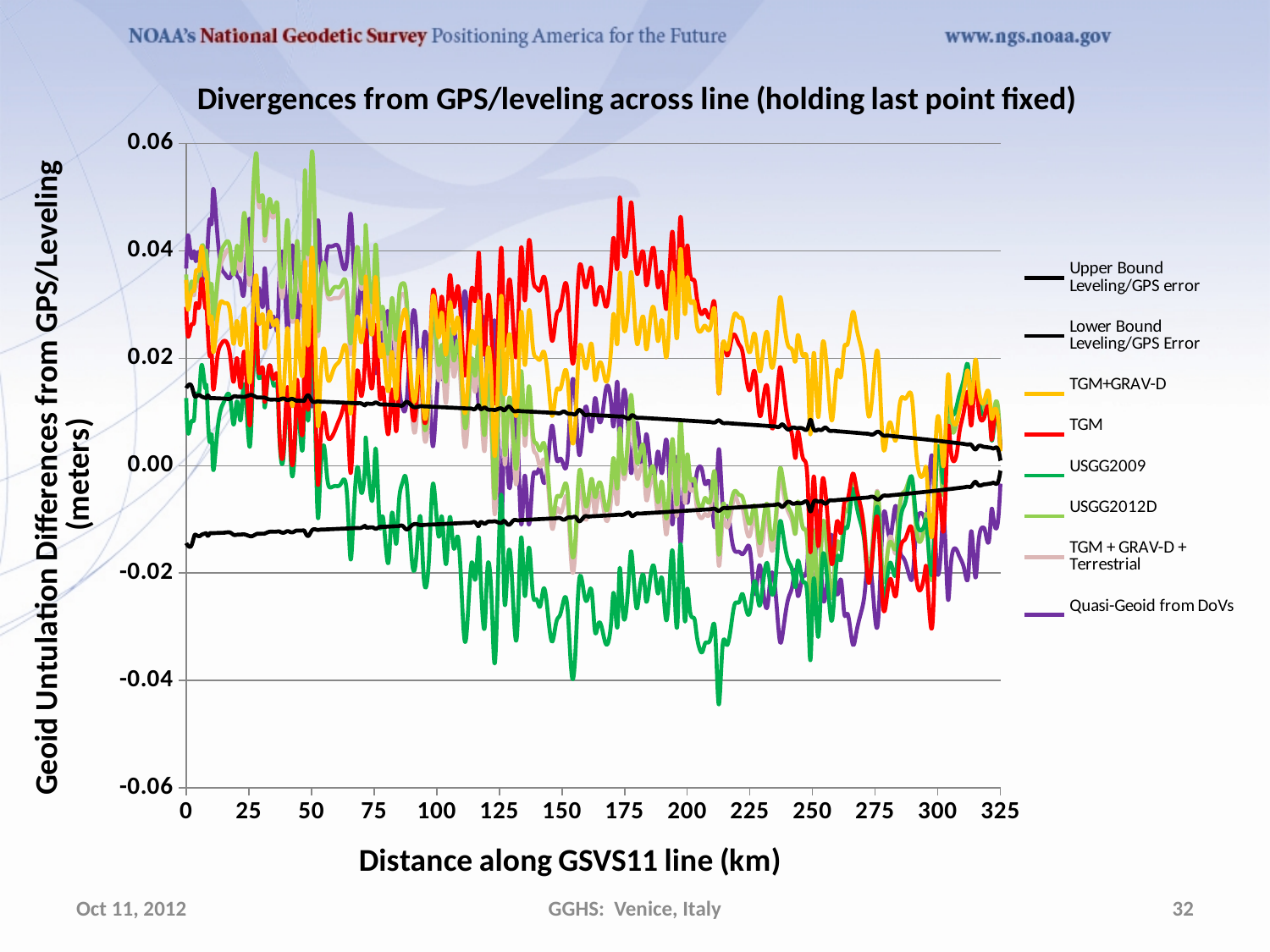
Is the value of the Lower Bound Leveling/GPS Error line at 0 km greater or less than 0.00? less How many series does the legend list? 8 What is the title of the chart? Divergences from GPS/leveling across line (holding last point fixed) At 150 km, which series has the larger value, TGM or USGG2009? TGM Is the value of the TGM series at 175 km greater or less than 0.02? greater Does the Upper Bound Leveling/GPS error line rise or fall as distance along the line increases? fall Is the value of the USGG2009 series at 150 km greater or less than 0.00? less Does the Lower Bound Leveling/GPS Error line rise or fall as distance along the line increases? rise What is the label of the x axis? Distance along GSVS11 line (km) What kind of chart is shown on the slide? line chart At 0 km, which line is higher, Upper Bound Leveling/GPS error or Lower Bound Leveling/GPS Error? Upper Bound Leveling/GPS error